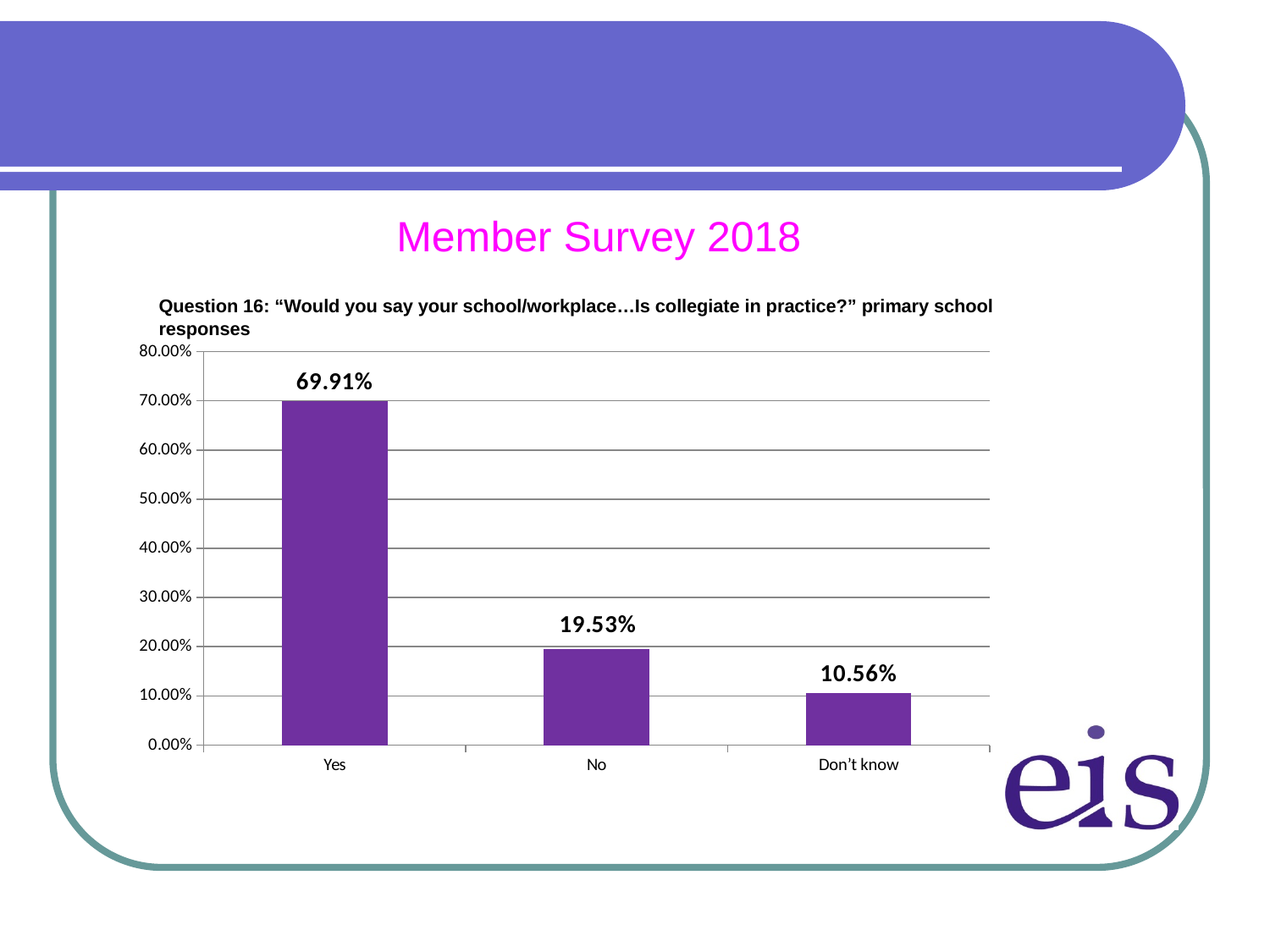
Which response category has the lowest percentage? Don't know What is the highest value shown on the vertical axis of the chart? 80.00% Which response category has the highest percentage? Yes How many response categories are shown on the chart? 3 What percentage of primary school respondents answered "Don't know"? 10.56% What kind of chart is shown on the slide? Bar chart What percentage of primary school respondents answered "No"? 19.53% What percentage of primary school respondents answered "Yes"? 69.91% Which is larger, the percentage for "No" or for "Don't know"? No What is the difference in percentage points between the "Yes" and "No" responses? 50.38% What is the difference in percentage points between the "No" and "Don't know" responses? 8.97% Is the value for "Yes" greater or less than 60.00%? greater